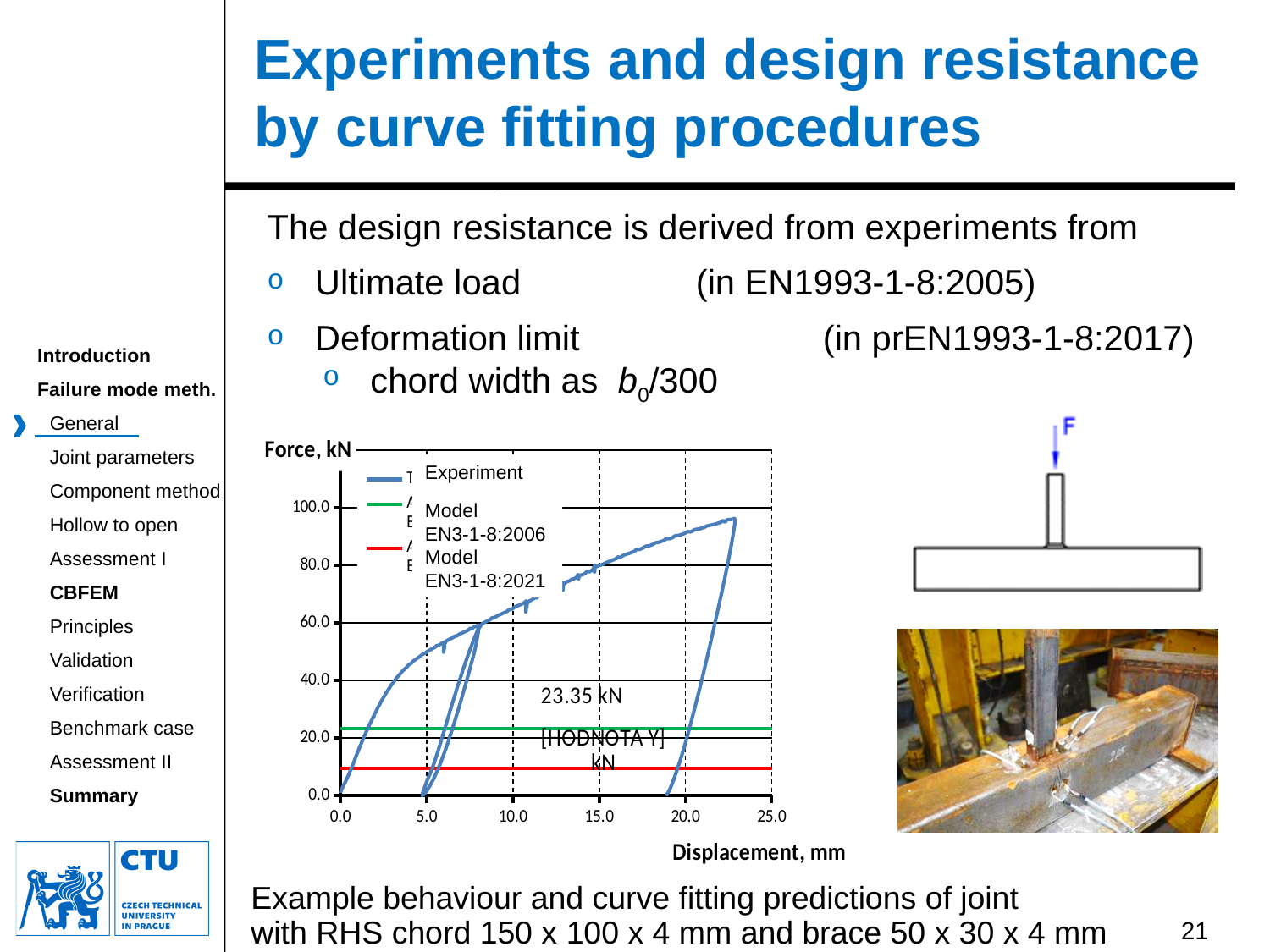
What force value is labelled on the Model EN3-1-8:2006 line? 23.35 kN Which model line lies higher, Model EN3-1-8:2006 or Model EN3-1-8:2021? Model EN3-1-8:2006 Is the force for the Model EN3-1-8:2021 line greater or less than 20.0 kN? less Which series has the lowest force level in the chart? Model EN3-1-8:2021 What is the label of the vertical axis of the chart? Force, kN Which series reaches the highest force in the chart? Experiment Does the Model EN3-1-8:2006 line rise, fall, or stay constant as displacement increases? stays constant Is the peak force of the Experiment curve greater or less than 100.0 kN? less What kind of chart is shown on the slide? line chart Is the peak force of the Experiment curve greater or less than 80.0 kN? greater How many series does the chart legend list? 3 What is the label of the horizontal axis of the chart? Displacement, mm